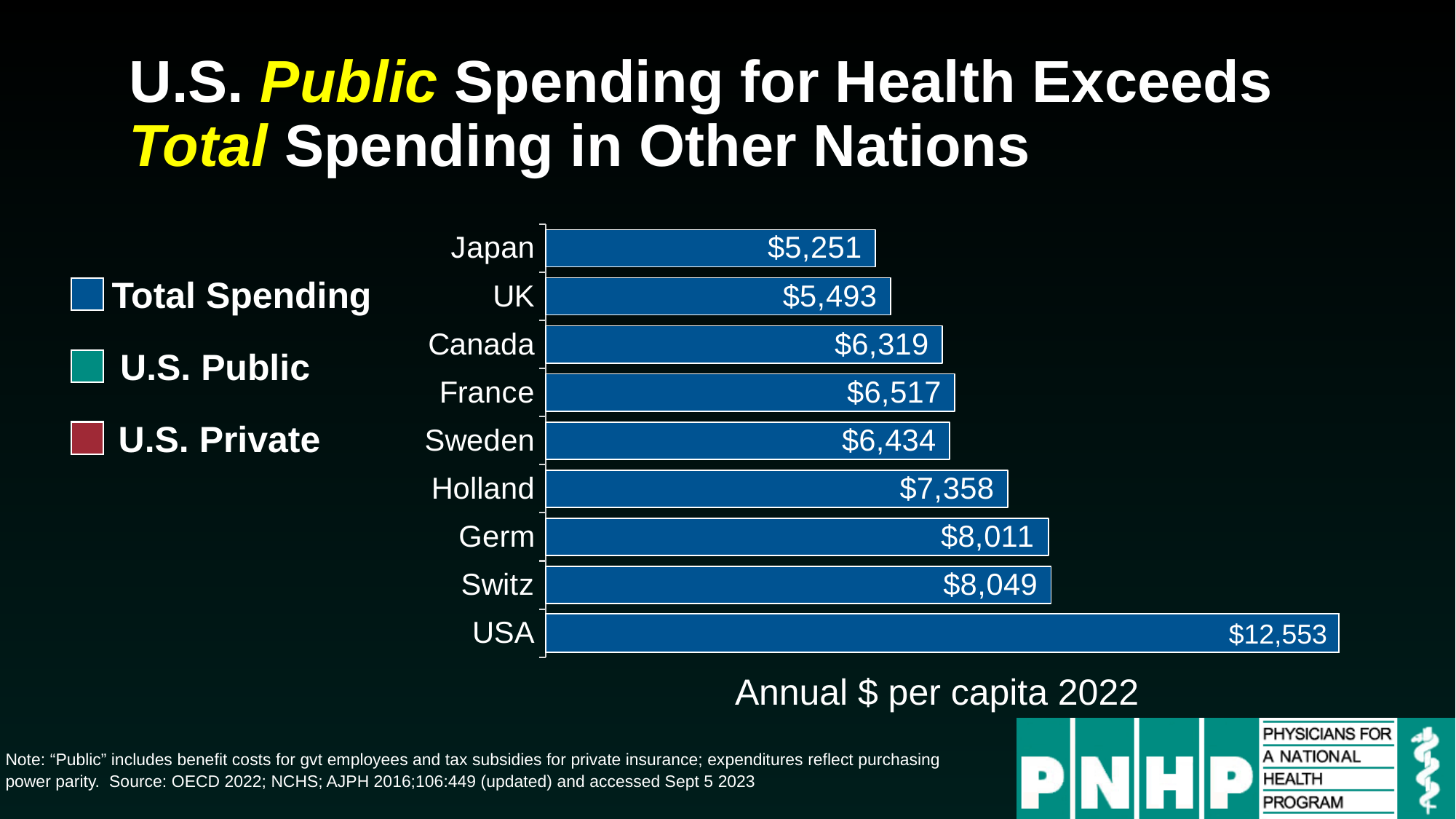
What is the value for the USA? $12,553 What is the difference between the France and Sweden values? $83 Which country has the highest value? USA How many countries are shown in the chart? 9 What kind of chart is shown on the slide? Bar chart What is the value for Japan? $5,251 Which country has the lowest value? Japan How many series does the legend list? 3 What is the value for Canada? $6,319 What is the difference between the USA and Switz values? $4,504 Which is larger, the value for Canada or the value for France? France What is the value for Holland? $7,358